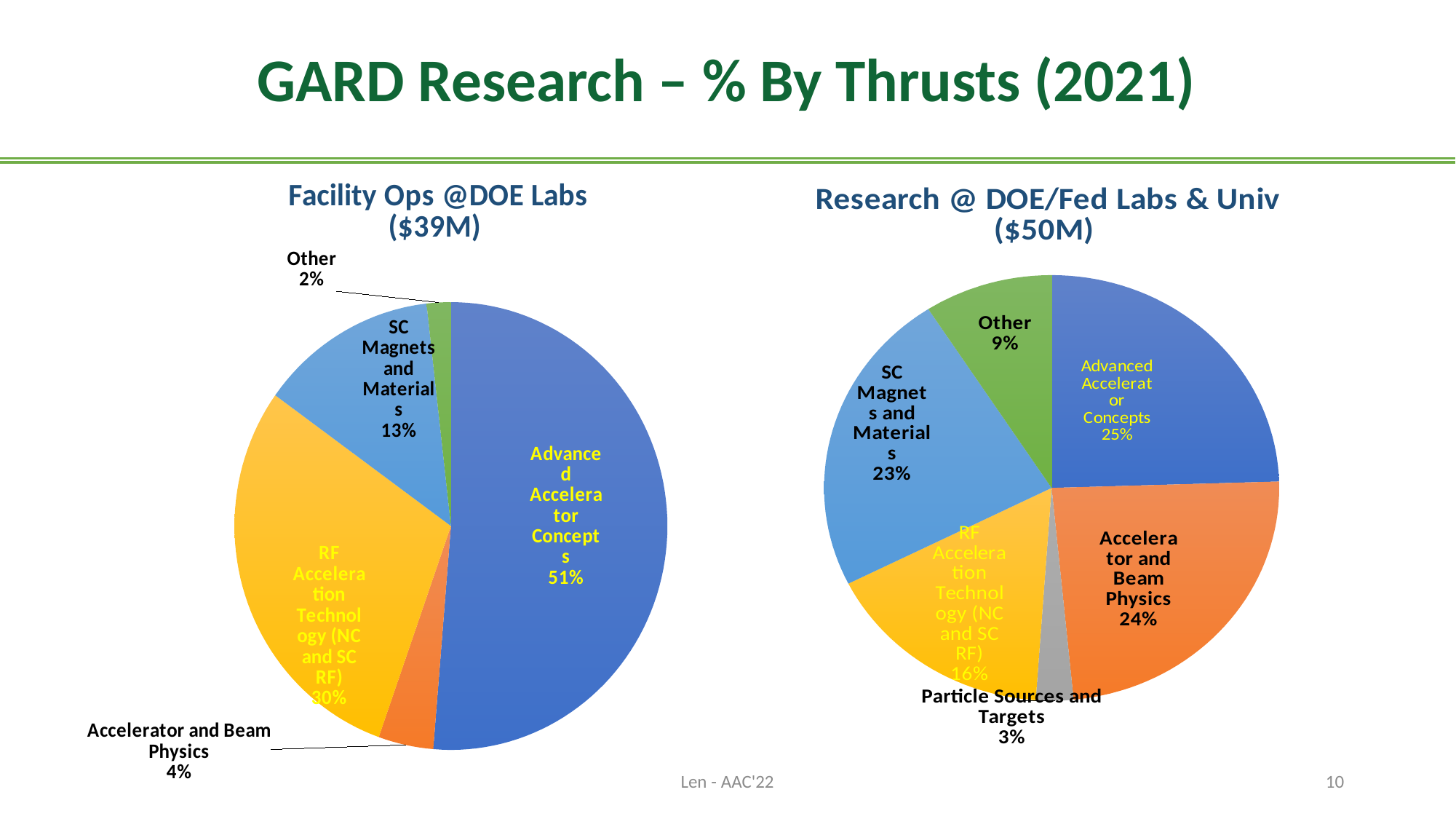
In the Research @ DOE/Fed Labs & Univ ($50M) chart, what share does Particle Sources and Targets have? 3% In the Research @ DOE/Fed Labs & Univ ($50M) chart, which category has the largest share? Advanced Accelerator Concepts In the Research @ DOE/Fed Labs & Univ ($50M) chart, what share does SC Magnets and Materials have? 23% What type of chart is used for Facility Ops @DOE Labs ($39M)? Pie chart In the Facility Ops @DOE Labs ($39M) chart, how many slices does the pie have? 5 In the Facility Ops @DOE Labs ($39M) chart, what is the difference between the shares of SC Magnets and Materials and Accelerator and Beam Physics? 9% In the Research @ DOE/Fed Labs & Univ ($50M) chart, which is larger: the share for Other or the share for RF Acceleration Technology (NC and SC RF)? RF Acceleration Technology (NC and SC RF) In the Research @ DOE/Fed Labs & Univ ($50M) chart, how many slices does the pie have? 6 In the Facility Ops @DOE Labs ($39M) chart, what share does Advanced Accelerator Concepts have? 51% In the Facility Ops @DOE Labs ($39M) chart, what share does RF Acceleration Technology (NC and SC RF) have? 30% In the Facility Ops @DOE Labs ($39M) chart, which category has the smallest share? Other What is the title of the chart on the right side of the slide? Research @ DOE/Fed Labs & Univ ($50M)